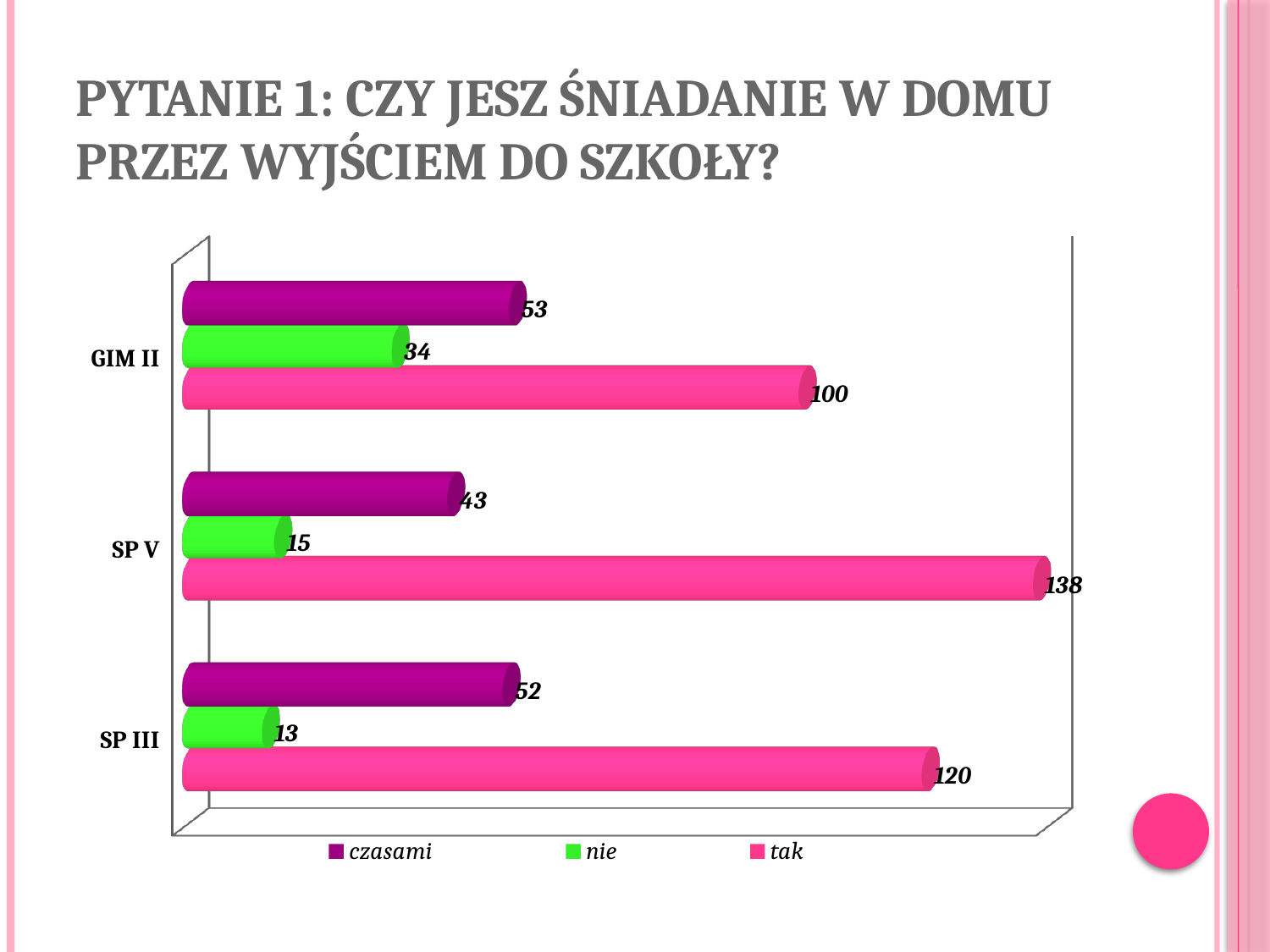
Which category has the highest "tak" value? SP V What is the difference between the "tak" values for SP V and SP III? 18 What is the value for "czasami" for SP III? 52 How many categories are shown on the chart? 3 Which is larger: the "czasami" value for GIM II or for SP V? GIM II Which category has the lowest "nie" value? SP III What is the value for "nie" for GIM II? 34 What is the total of the three values for GIM II? 187 How many series does the legend list? 3 Which series is shown in green in the legend? nie What is the value for "tak" for SP V? 138 What kind of chart is shown on the slide? bar chart